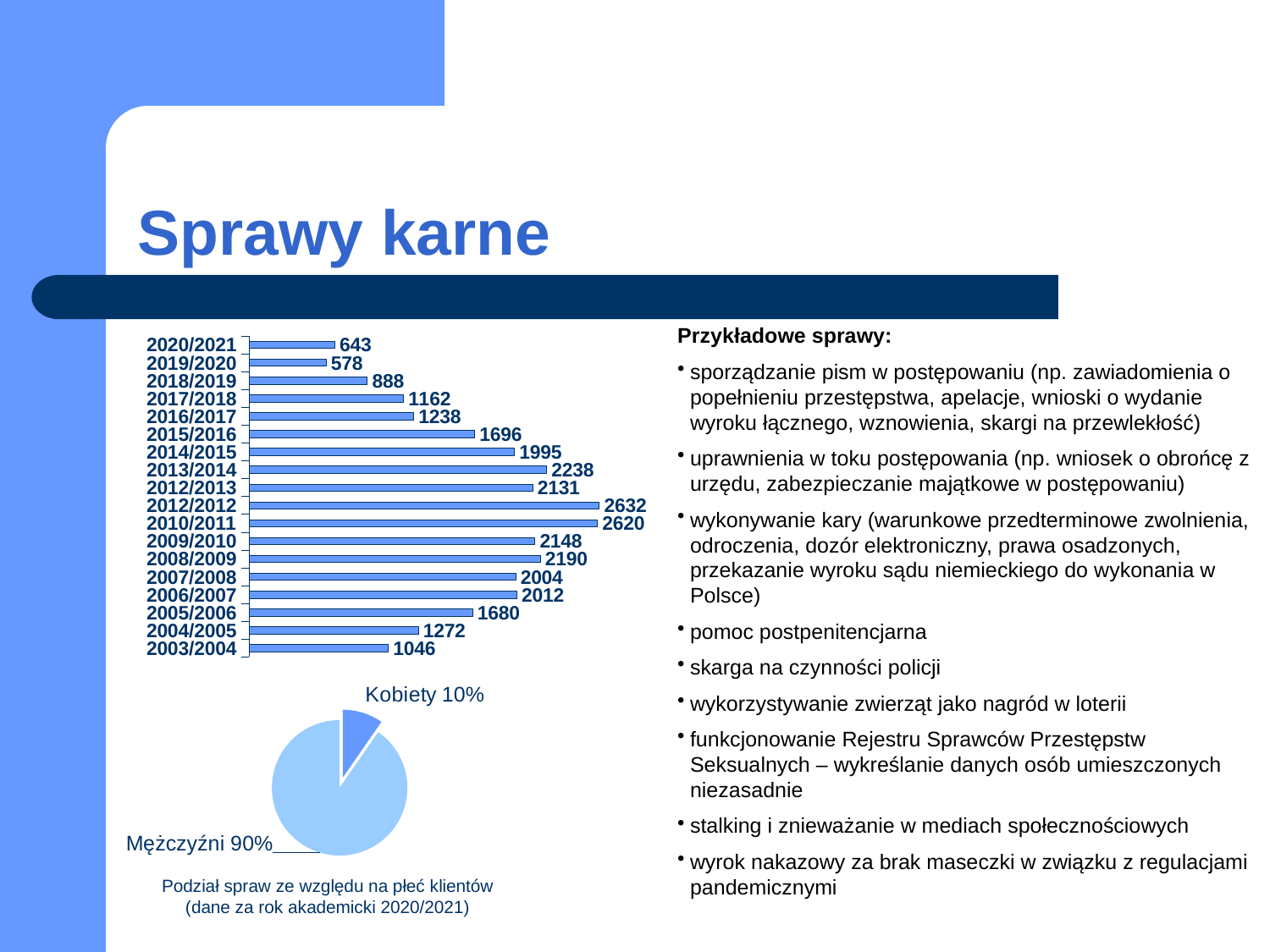
In the bar chart at the top left, which category has the lowest value? 2019/2020 What kind of chart is the chart at the top left of the slide? Bar chart What kind of chart is the chart at the bottom left of the slide? Pie chart In the bar chart at the top left, do the values rise or fall from 2016/2017 to 2019/2020? Fall In the bar chart at the top left, what is the value for 2020/2021? 643 In the bar chart at the top left, what is the value for 2015/2016? 1696 In the pie chart at the bottom left, what share of cases is for Kobiety? 10% In the bar chart at the top left, how many categories (academic years) are shown? 18 In the bar chart at the top left, what is the highest value shown? 2632 In the bar chart at the top left, what is the value for 2003/2004? 1046 In the bar chart at the top left, which is larger: the value for 2008/2009 or the value for 2009/2010? 2008/2009 In the bar chart at the top left, what is the difference between the values for 2013/2014 and 2012/2013? 107